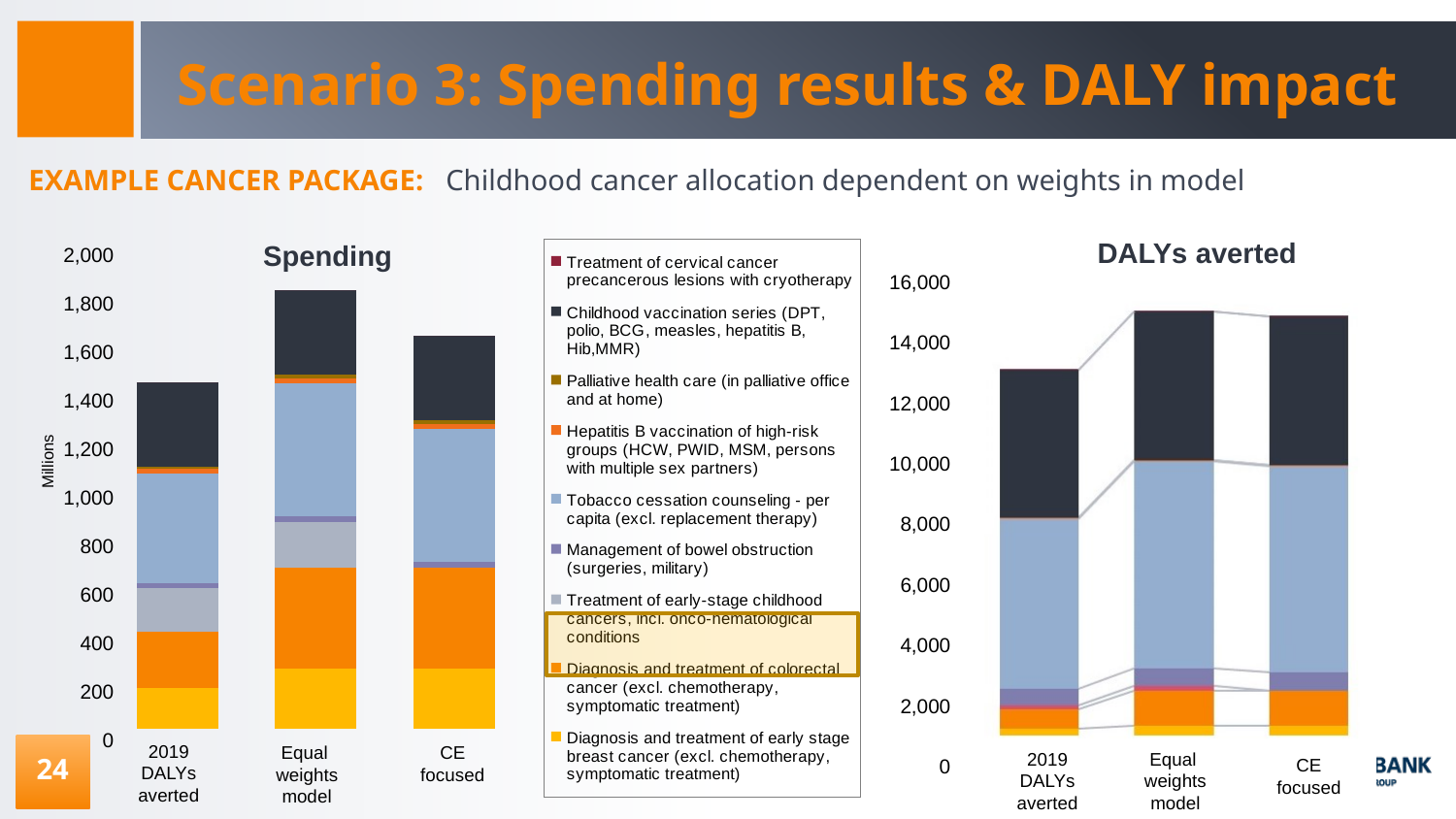
In the Spending chart, is the total for 2019 DALYs averted greater or less than 1,400? greater In the Spending chart, which has the larger total: Equal weights model or CE focused? Equal weights model In the DALYs averted chart, is the total for Equal weights model greater or less than 14,000? greater What kind of chart is the Spending chart? Stacked bar chart In the DALYs averted chart, which category has the lowest total? 2019 DALYs averted How many categories are shown on the x axis of the DALYs averted chart? 3 In the Spending chart, is the total for CE focused greater or less than 1,800? less How many series does the legend between the two charts list? 9 What unit is shown on the y axis of the Spending chart? Millions In the Spending chart, which category has the shortest total bar? 2019 DALYs averted In the Spending chart, which category has the tallest total bar? Equal weights model